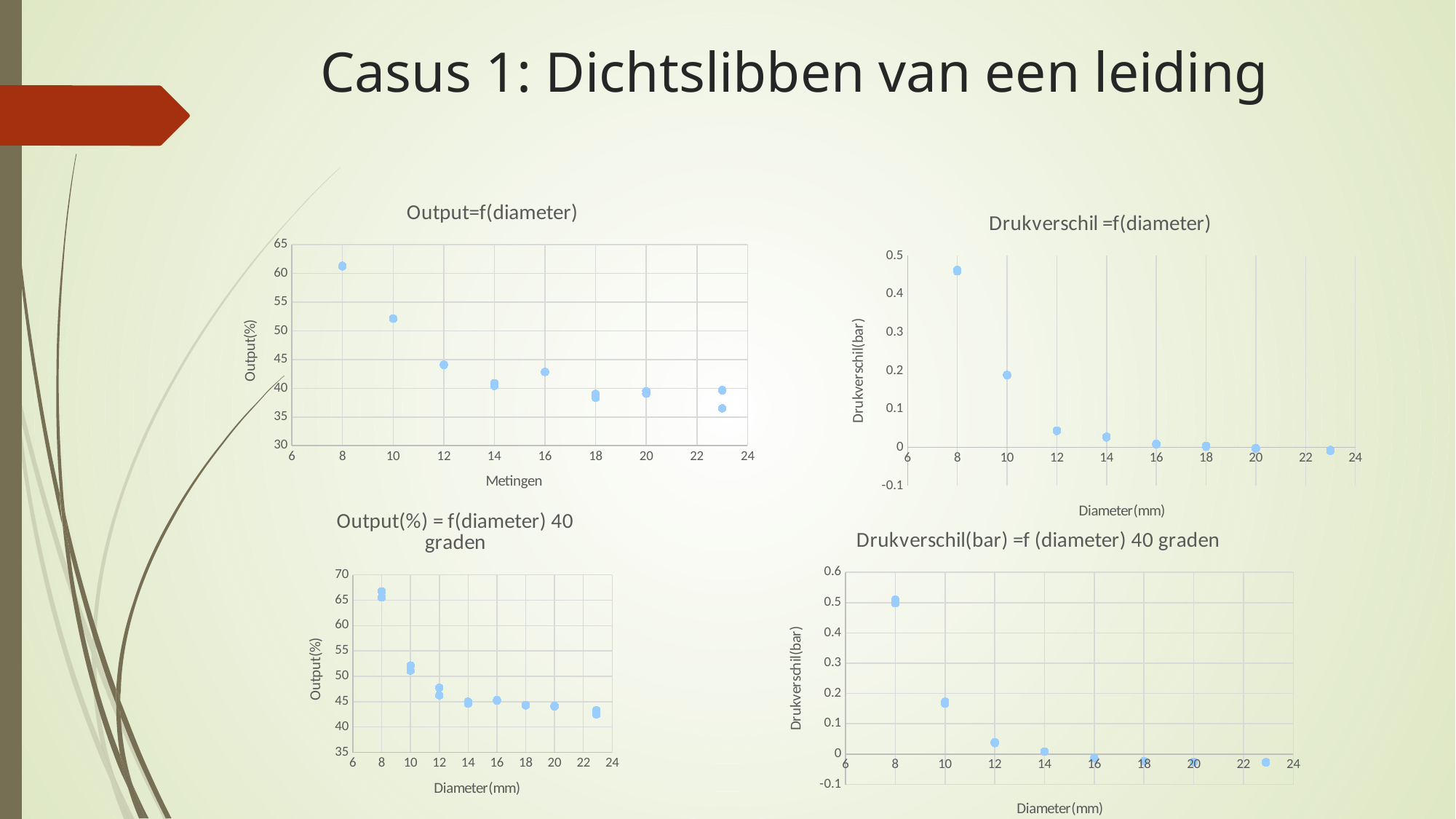
In the top-left chart "Output=f(diameter)", at which x-axis value is the output highest? 8 What is the x-axis title of the top-left chart "Output=f(diameter)"? Metingen What kind of chart is the top-left chart titled "Output=f(diameter)"? scatter chart In the top-right chart "Drukverschil =f(diameter)", is the value at diameter 10 greater or less than 0.3? less In the top-left chart "Output=f(diameter)", is the output at x = 10 greater or less than 50? greater In the top-left chart "Output=f(diameter)", do the output values rise or fall as the x-axis value increases? fall In the bottom-left chart "Output(%) = f(diameter) 40 graden", are the output values at diameter 12 greater or less than 50? less In the top-right chart "Drukverschil =f(diameter)", at which diameter is the pressure difference highest? 8 How many charts are shown on the slide? 4 In the bottom-right chart "Drukverschil(bar) =f (diameter) 40 graden", do the values rise or fall as the diameter increases? fall